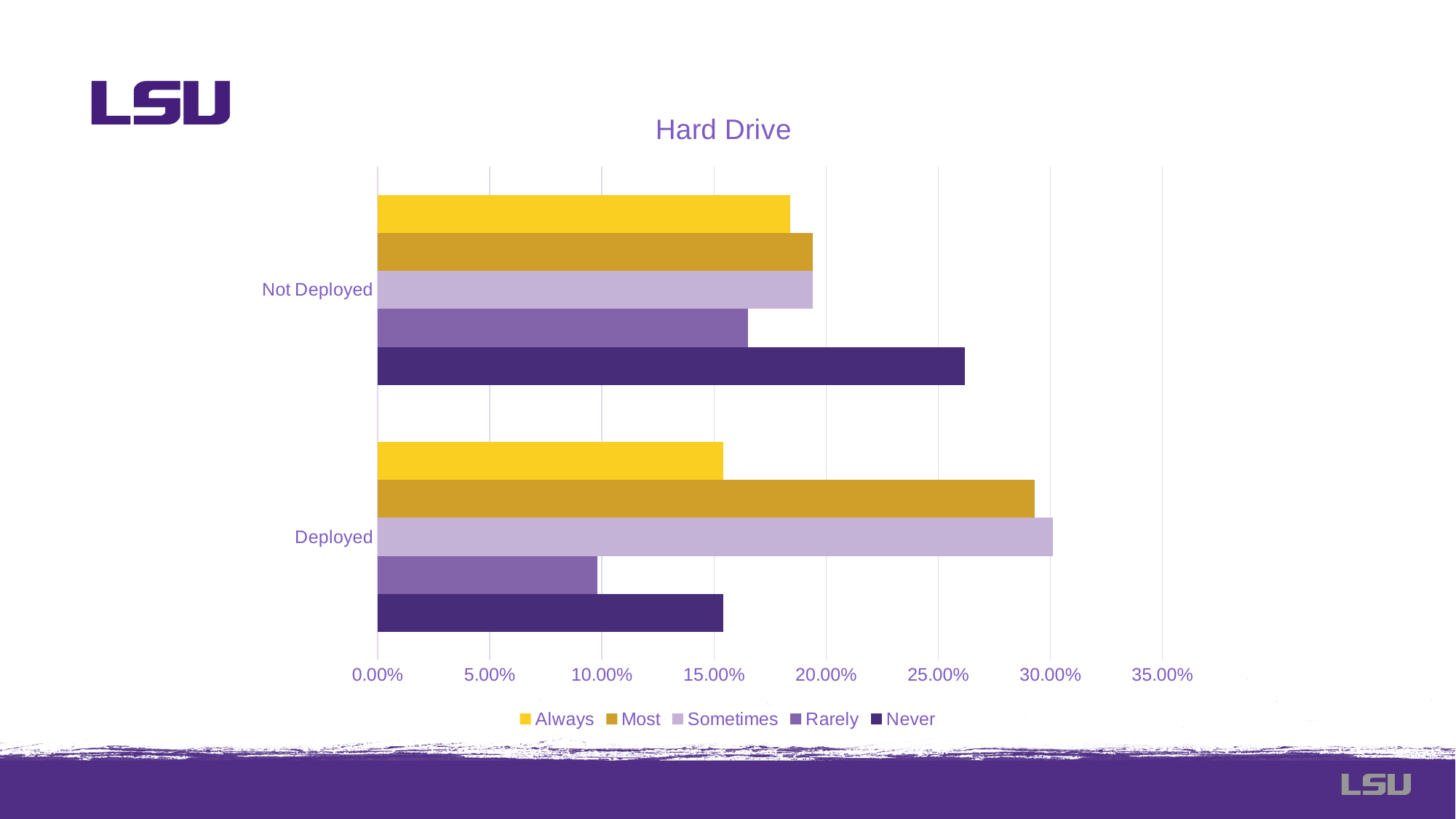
Which is larger, the Never value for Not Deployed or the Never value for Deployed? Not Deployed How many categories are shown on the vertical axis? 2 Is the Most value for Deployed greater or less than 25.00%? greater Which series has the lowest value for Not Deployed? Rarely What is the title of the chart? Hard Drive Is the Never value for Not Deployed greater or less than 25.00%? greater Is the Rarely value for Deployed greater or less than 15.00%? less Which series has the lowest value for Deployed? Rarely Which is larger, the Most value for Deployed or the Most value for Not Deployed? Deployed Which series has the highest value for Not Deployed? Never What kind of chart is shown on the slide? Bar chart How many series does the legend list? 5